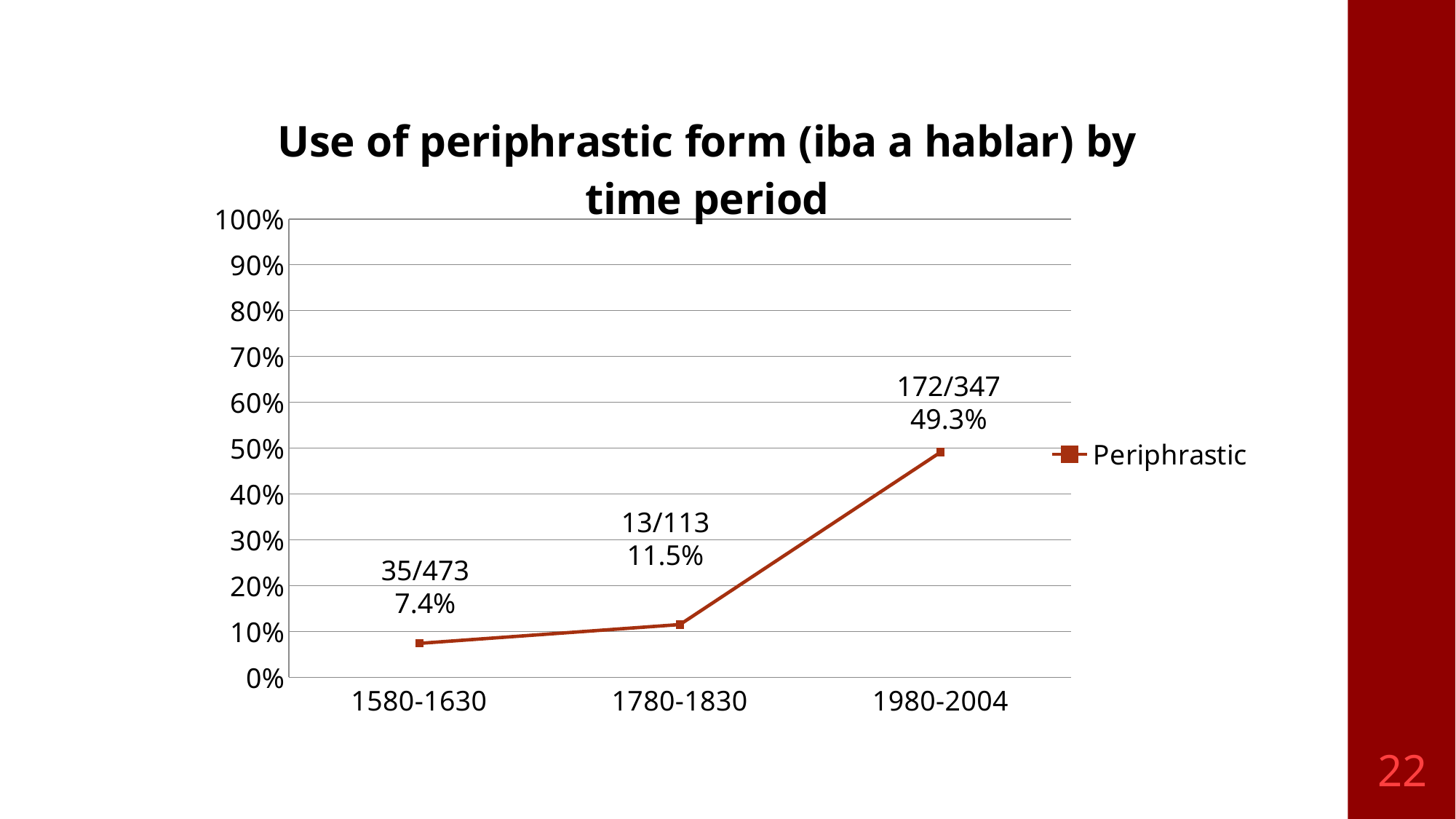
Which time period has the highest percentage of periphrastic form use? 1980-2004 What kind of chart is shown on the slide? line chart Is the value for 1980-2004 greater or less than 40%? greater Which time period has a larger percentage, 1580-1630 or 1780-1830? 1780-1830 What is the percentage value for the 1780-1830 time period? 11.5% What is the percentage value for the 1580-1630 time period? 7.4% Do the values rise or fall from 1580-1630 to 1980-2004? rise What is the difference in percentage points between the 1980-2004 and 1780-1830 time periods? 37.8 What fraction is shown as the data label for the 1980-2004 time period? 172/347 Which time period has the lowest percentage of periphrastic form use? 1580-1630 How many time periods are plotted on the x axis? 3 What is the percentage value for the 1980-2004 time period? 49.3%